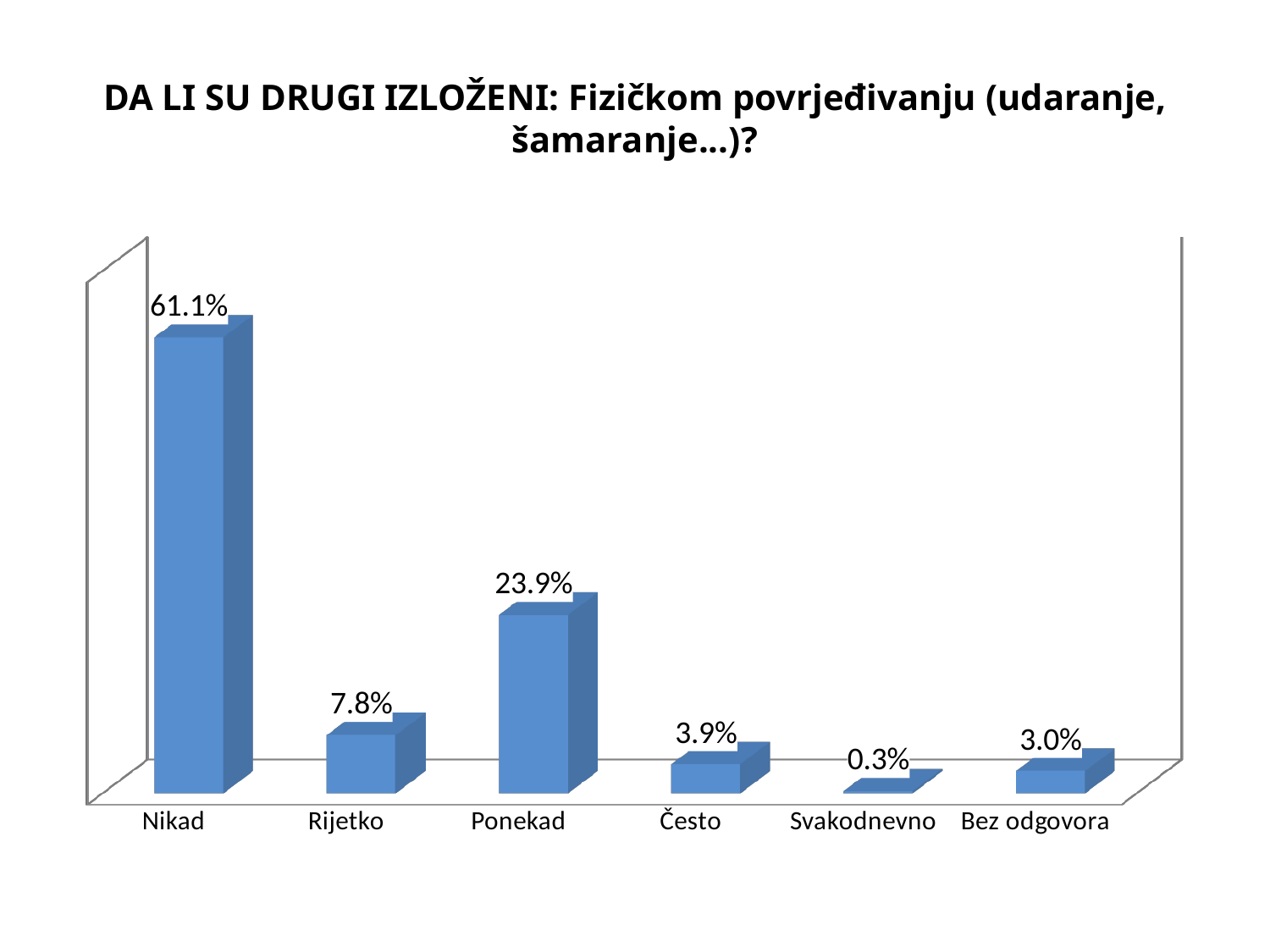
What is the difference between the values for Često and Bez odgovora? 0.9% What is the value for Nikad? 61.1% How many categories are shown on the x axis? 6 What kind of chart is shown on the slide? Bar chart Which is larger, the value for Rijetko or the value for Često? Rijetko What is the value for Ponekad? 23.9% What is the value for Rijetko? 7.8% What is the value for Svakodnevno? 0.3% Which category has the highest value? Nikad Which category has the lowest value? Svakodnevno What is the value for Bez odgovora? 3.0% What is the difference between the values for Nikad and Ponekad? 37.2%